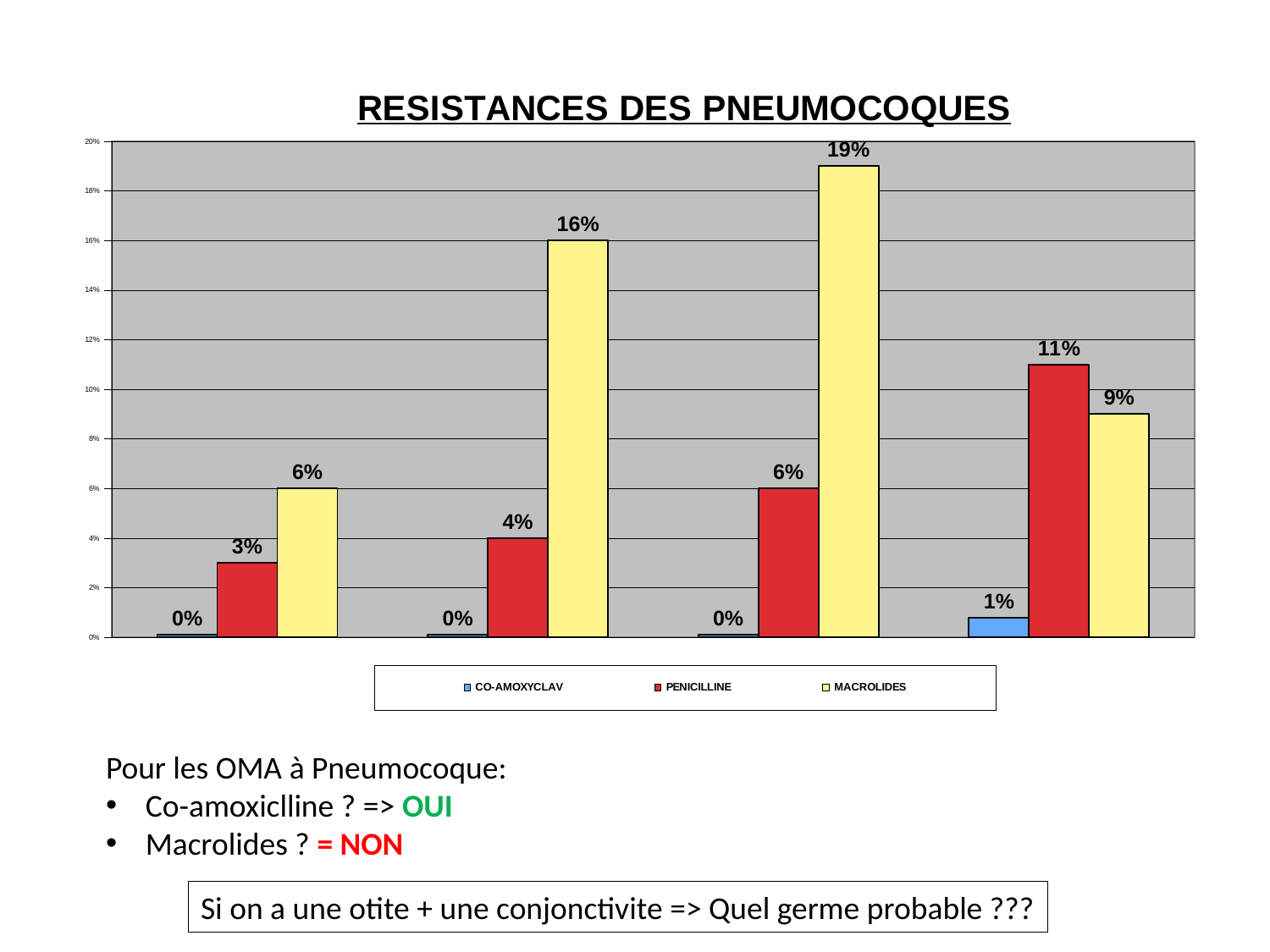
Which series has the highest value in the second group of bars from the left? MACROLIDES Which colour represents the MACROLIDES series in the chart? yellow How many series does the legend list? 3 What is the value of the CO-AMOXYCLAV bar in the rightmost group of bars? 1% What is the difference between the MACROLIDES value and the PENICILLINE value in the second group of bars from the left? 12% What is the value of the PENICILLINE bar in the fourth (rightmost) group of bars? 11% What kind of chart is shown on the slide? bar chart What is the value of the MACROLIDES bar in the third group of bars from the left? 19% Which series has the lowest value in the rightmost group of bars? CO-AMOXYCLAV In the rightmost group of bars, which is larger: the PENICILLINE value or the MACROLIDES value? PENICILLINE What is the title of the chart? RESISTANCES DES PNEUMOCOQUES How many groups of bars are plotted along the x axis? 4